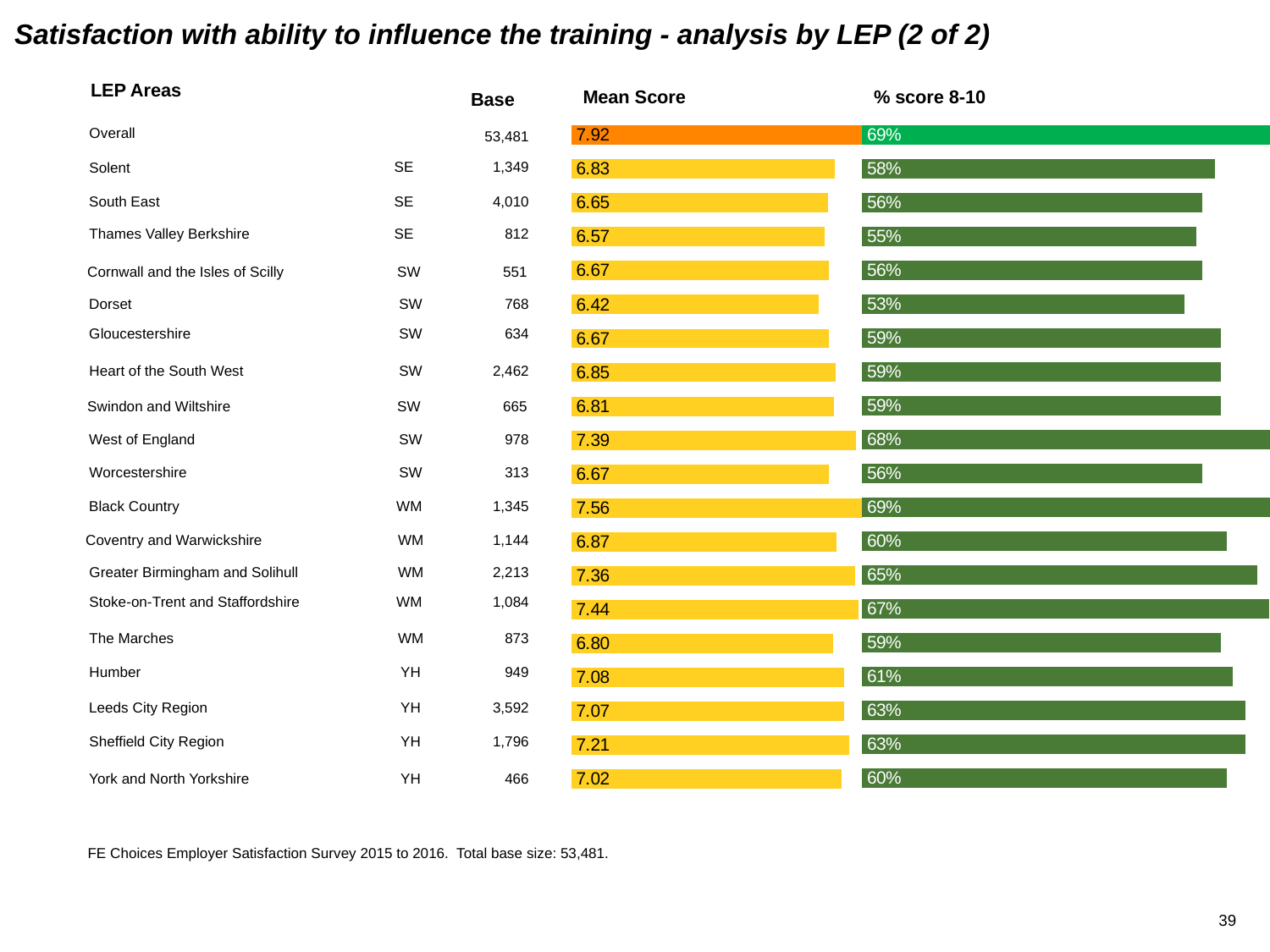
In the % score 8-10 chart, what is the difference between Black Country and Coventry and Warwickshire? 9% In the Mean Score chart, what is the difference between the Overall mean score and the mean score for Solent? 1.09 In the Mean Score chart, which has the higher mean score, West of England or Greater Birmingham and Solihull? West of England In the % score 8-10 chart, what is the value for Humber? 61% What type of chart is used to show the % score 8-10 values? Bar chart In the Mean Score chart, which LEP area (excluding Overall) has the highest mean score? Black Country In the Mean Score chart, which LEP area has the lowest mean score? Dorset In the % score 8-10 chart, which LEP area has the lowest value? Dorset In the Mean Score chart, what is the mean score for Dorset? 6.42 In the % score 8-10 chart, what is the value for West of England? 68% How many LEP area rows (including Overall) are shown in the Mean Score chart? 20 In the Mean Score chart, what is the mean score for Stoke-on-Trent and Staffordshire? 7.44